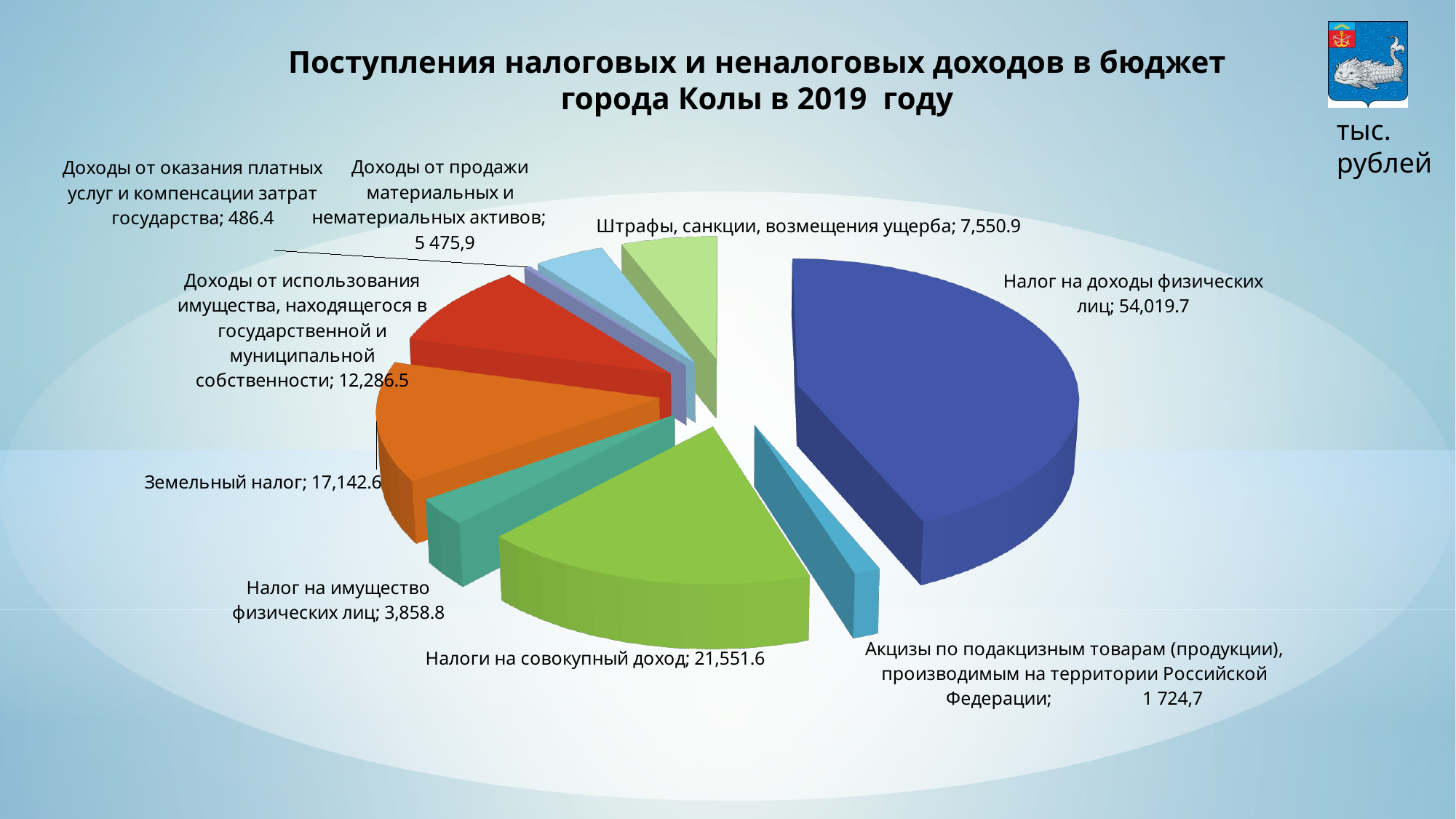
What is the value for «Штрафы, санкции, возмещения ущерба»? 7,550.9 How many categories (slices) does the pie chart have? 9 What is the value for «Налог на доходы физических лиц»? 54,019.7 Which is larger: «Налог на имущество физических лиц» or «Доходы от продажи материальных и нематериальных активов»? Доходы от продажи материальных и нематериальных активов What is the difference between «Земельный налог» and «Доходы от использования имущества, находящегося в государственной и муниципальной собственности»? 4,856.1 What is the difference between «Налог на доходы физических лиц» and «Налоги на совокупный доход»? 32,468.1 What is the value for «Акцизы по подакцизным товарам (продукции), производимым на территории Российской Федерации»? 1 724,7 What kind of chart is shown on the slide? Pie chart What is the value for «Земельный налог»? 17,142.6 Which category has the largest value? Налог на доходы физических лиц Which category has the smallest value? Доходы от оказания платных услуг и компенсации затрат государства In what units are the values on the chart given? тыс. рублей